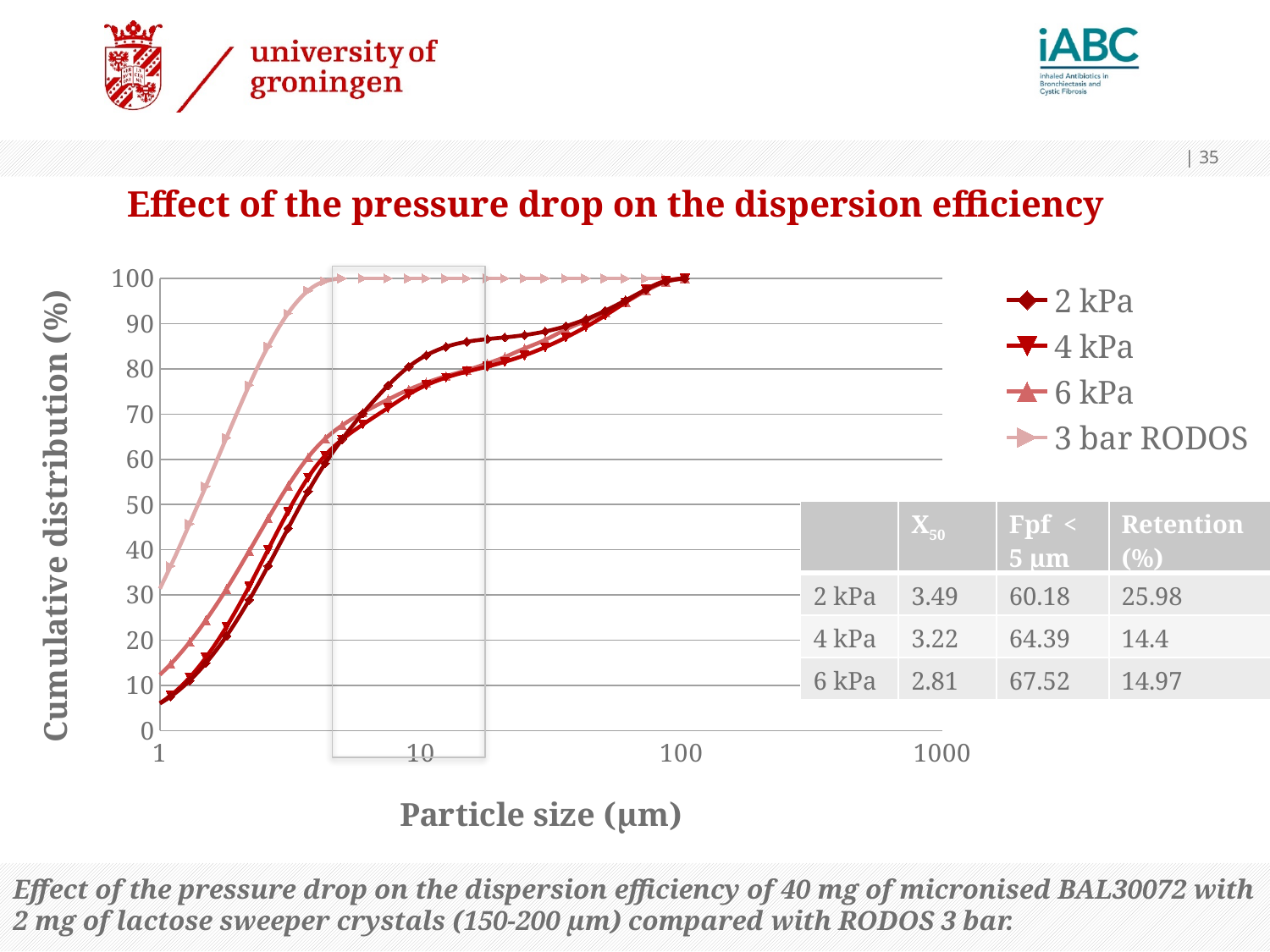
At a particle size of 1 µm, is the cumulative distribution for 3 bar RODOS greater or less than 20? greater What is the title of the chart on the slide? Effect of the pressure drop on the dispersion efficiency How many series does the chart legend list? 4 What is the label of the vertical axis of the chart? Cumulative distribution (%) What kind of chart is shown on the slide? line chart At a particle size of 1 µm, is the cumulative distribution for 2 kPa greater or less than 20? less At a particle size of 10 µm, which series has the larger cumulative distribution, 3 bar RODOS or 4 kPa? 3 bar RODOS At a particle size of 10 µm, is the cumulative distribution for 3 bar RODOS greater or less than 90? greater Which series reaches 100% cumulative distribution at the smallest particle size? 3 bar RODOS Do the values of the 2 kPa series rise or fall as particle size increases along the x axis? rise Which series has the highest cumulative distribution at a particle size of 1 µm? 3 bar RODOS